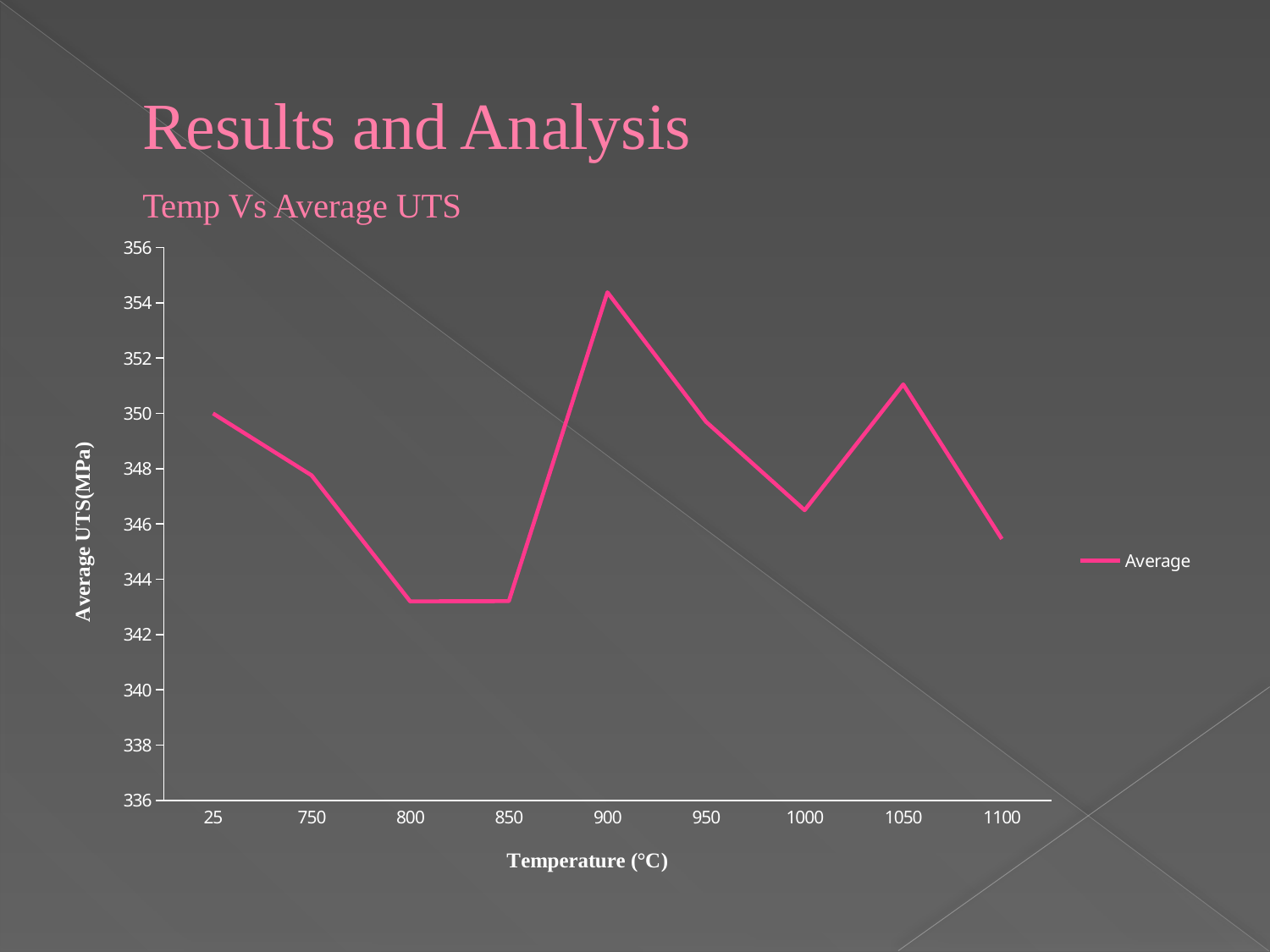
Which has the higher average UTS, 900 °C or 1050 °C? 900 What is the label on the y axis of the chart? Average UTS(MPa) Is the average UTS at 900 °C greater or less than 352? greater At which temperature is the average UTS highest? 900 Which has the higher average UTS, 25 °C or 1100 °C? 25 How many series does the legend list? 1 Is the average UTS at 800 °C greater or less than 344? less How many temperature points are plotted on the chart? 9 What kind of chart is shown on the slide? line chart Is the average UTS at 1000 °C greater or less than 348? less Does the average UTS rise or fall from 25 °C to 800 °C? fall